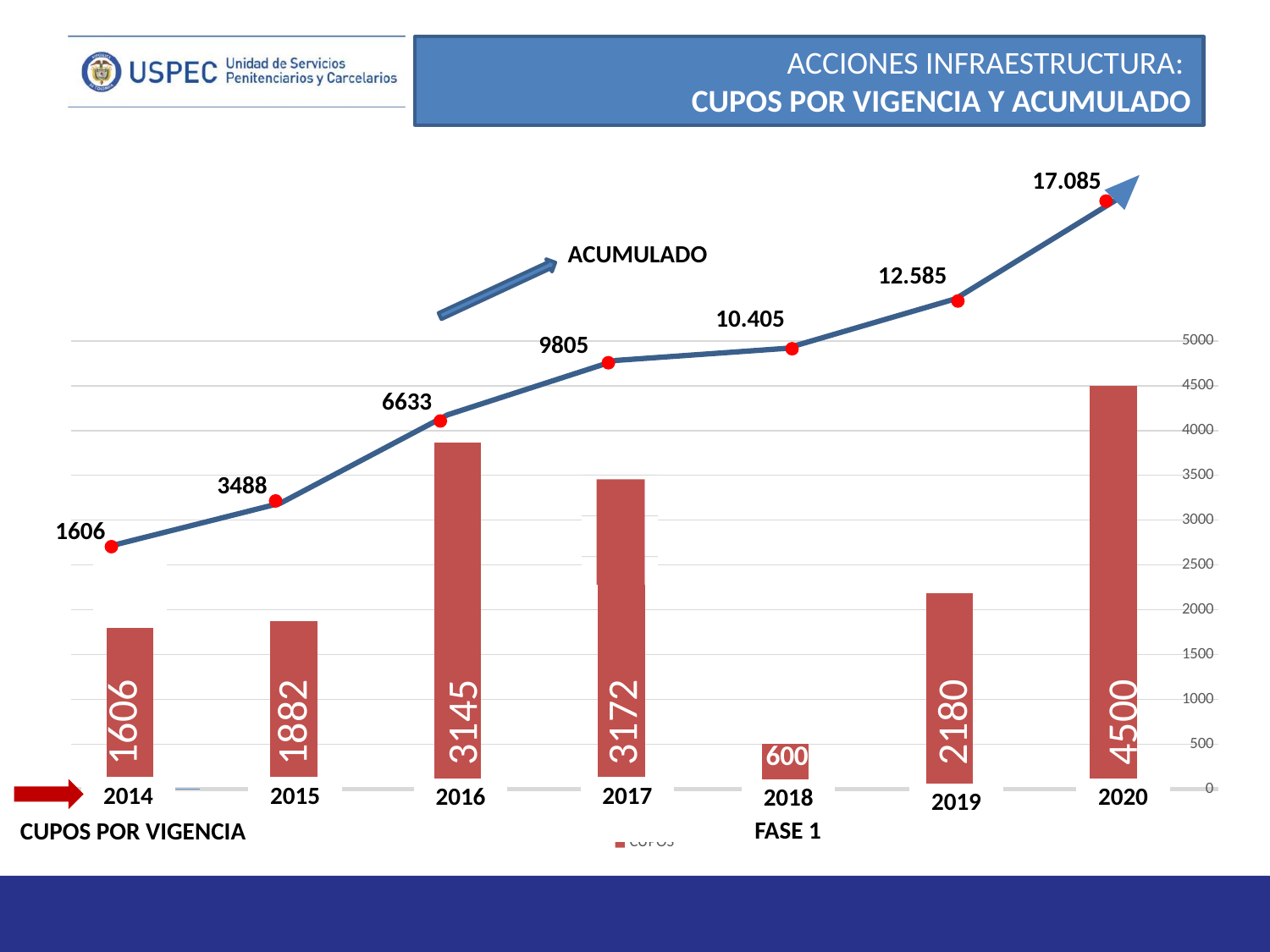
Does the ACUMULADO line rise or fall from 2014 to 2020? rise What is the difference between the ACUMULADO values for 2015 and 2014? 1882 What is the title of the chart? ACCIONES INFRAESTRUCTURA: CUPOS POR VIGENCIA Y ACUMULADO What is the ACUMULADO value for 2020? 17.085 Which year has the highest CUPOS POR VIGENCIA value? 2020 What is the CUPOS POR VIGENCIA value for 2016? 3145 What is the difference between the CUPOS POR VIGENCIA values for 2020 and 2019? 2320 What is the ACUMULADO value for 2019? 12.585 How many years are shown on the x axis? 7 Which year has the lowest CUPOS POR VIGENCIA value? 2018 Which is larger, the CUPOS POR VIGENCIA value for 2017 or for 2016? 2017 What is the CUPOS POR VIGENCIA value for 2018? 600